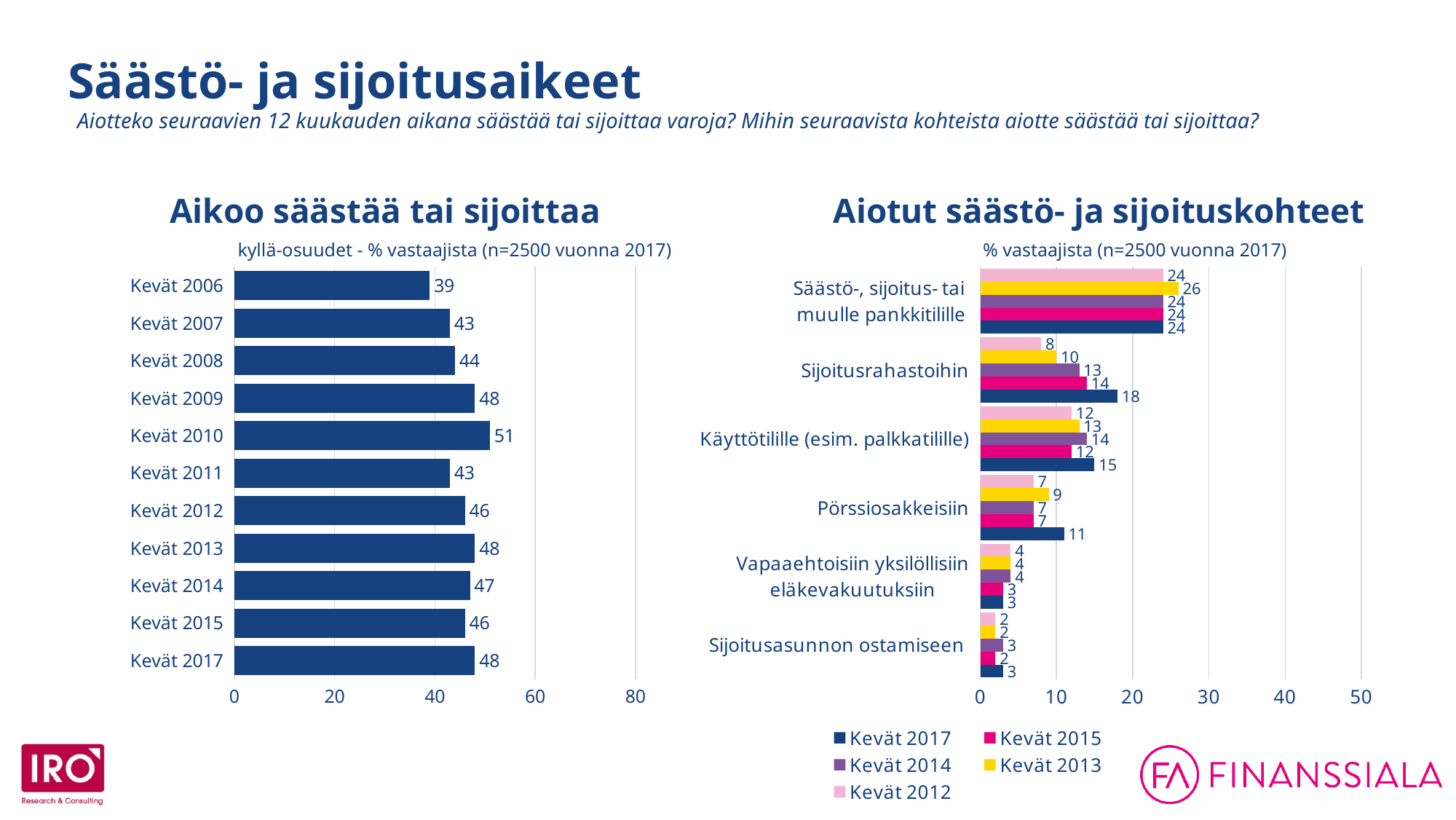
In the 'Aiotut säästö- ja sijoituskohteet' chart, which is larger for Pörssiosakkeisiin: Kevät 2017 or Kevät 2013? Kevät 2017 In the 'Aiotut säästö- ja sijoituskohteet' chart, how many categories are shown? 6 In the 'Aikoo säästää tai sijoittaa' chart, which year has the highest value? Kevät 2010 In the 'Aiotut säästö- ja sijoituskohteet' chart, how many series does the legend list? 5 In the 'Aikoo säästää tai sijoittaa' chart, how many years are shown? 11 In the 'Aikoo säästää tai sijoittaa' chart, what is the difference between Kevät 2017 and Kevät 2006? 9 In the 'Aikoo säästää tai sijoittaa' chart, which year has the lowest value? Kevät 2006 In the 'Aiotut säästö- ja sijoituskohteet' chart, what is the difference between the Kevät 2017 and Kevät 2012 values for Sijoitusrahastoihin? 10 In the 'Aiotut säästö- ja sijoituskohteet' chart, what is the Kevät 2017 value for Sijoitusrahastoihin? 18 What type of chart is 'Aikoo säästää tai sijoittaa'? Bar chart In the 'Aikoo säästää tai sijoittaa' chart, what is the value for Kevät 2010? 51 In the 'Aiotut säästö- ja sijoituskohteet' chart, what is the Kevät 2013 value for 'Säästö-, sijoitus- tai muulle pankkitilille'? 26